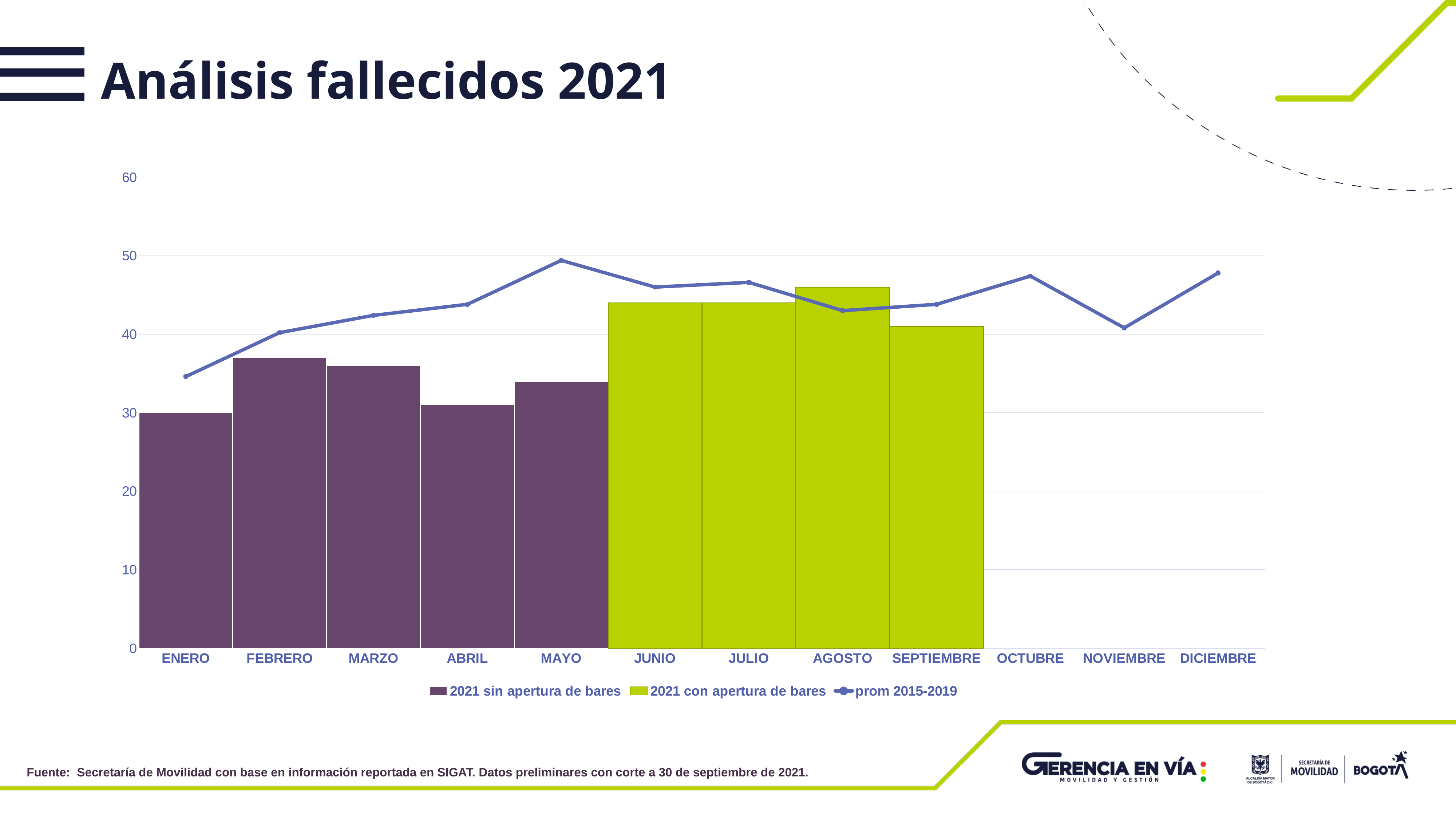
Which series is shown in green bars? 2021 con apertura de bares How many month categories are shown on the x axis? 12 Which month has the shortest bar? ENERO Is the bar for JUNIO greater or less than 40? greater Does the prom 2015-2019 line rise or fall from ENERO to MAYO? rise How many series does the legend list? 3 How many months have a bar plotted? 9 Is the bar for ABRIL greater or less than 40? less Which is larger, the bar for FEBRERO or the bar for ABRIL? FEBRERO What is the value of the bar for ENERO? 30 What is the title of the chart on the slide? Análisis fallecidos 2021 Which month has the tallest bar? AGOSTO